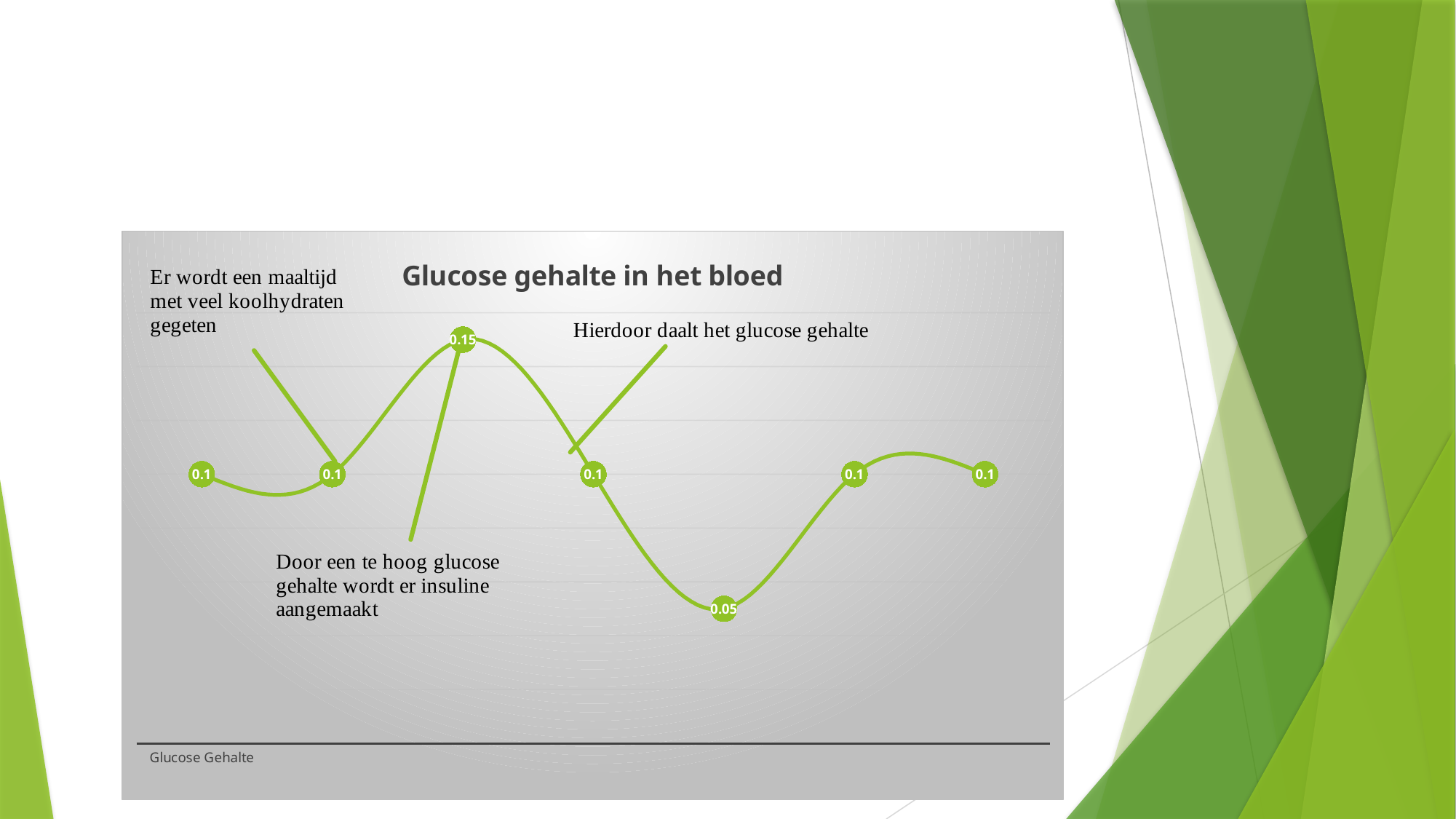
What is the title of the chart? Glucose gehalte in het bloed What is the value of the last data point on the line? 0.1 How many data points are plotted on the line? 7 Do the values rise or fall from the third data point to the fifth data point? fall What is the value of the first data point on the line? 0.1 What is the difference between the highest and lowest values on the line? 0.1 What kind of chart is shown on the slide? line chart What is the lowest value plotted on the line? 0.05 What is the highest value plotted on the line? 0.15 Which is larger, the third data point or the fifth data point? the third data point